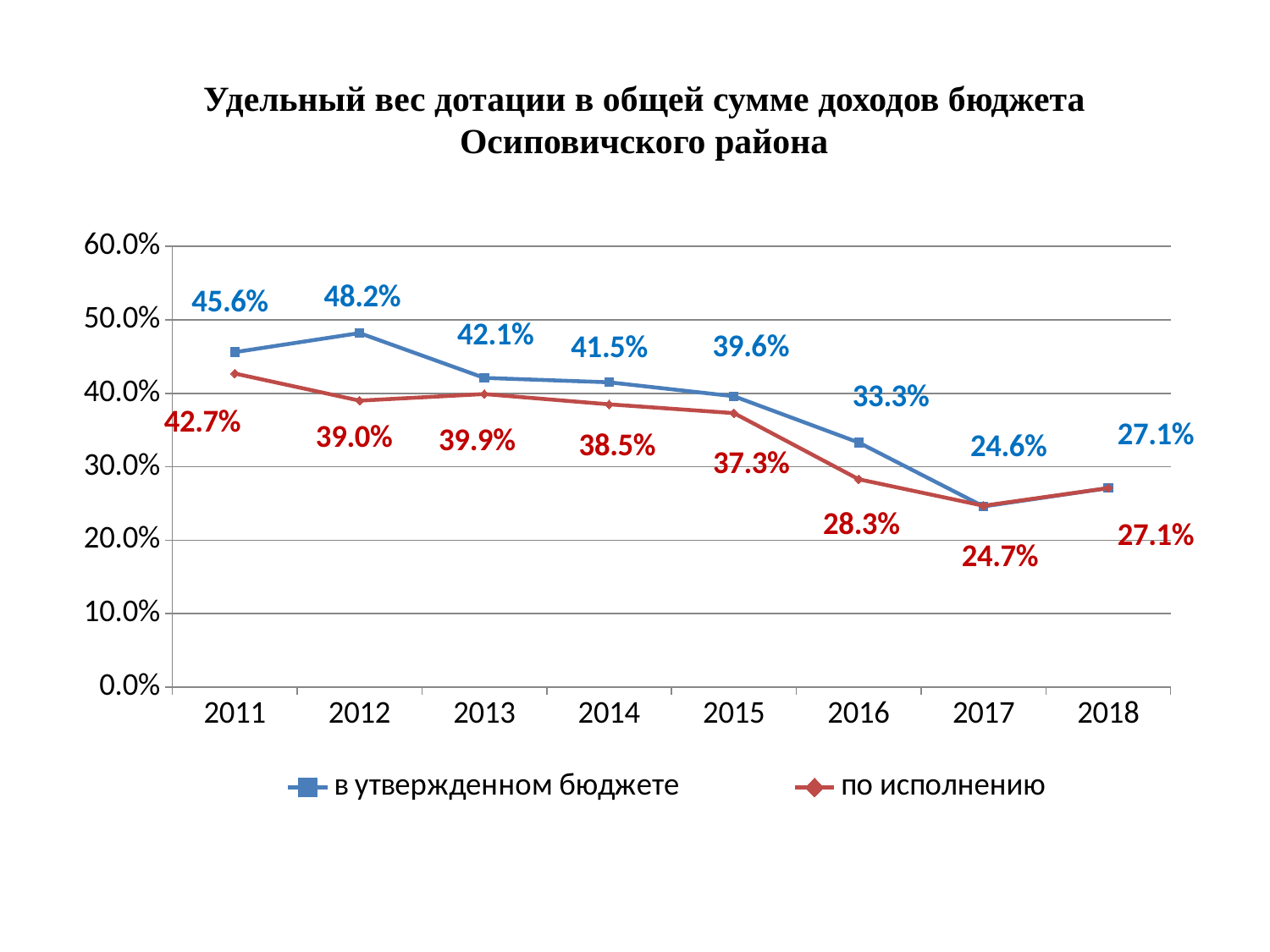
Which year has the lowest value in the 'по исполнению' series? 2017 What colour is the line for the 'по исполнению' series? red Do the 'в утвержденном бюджете' values generally rise or fall from 2012 to 2017? fall What is the value for 2016 in the 'по исполнению' series? 28.3% Which is larger for 2013: the 'в утвержденном бюджете' value or the 'по исполнению' value? в утвержденном бюджете What kind of chart is shown on the slide? line chart How many series does the legend list? 2 How many years are shown on the x axis? 8 What is the value for 2012 in the 'в утвержденном бюджете' series? 48.2% What is the difference between the 'в утвержденном бюджете' and 'по исполнению' values for 2016? 5.0% Is the 'по исполнению' value for 2015 greater or less than 30.0%? greater Which year has the highest value in the 'в утвержденном бюджете' series? 2012